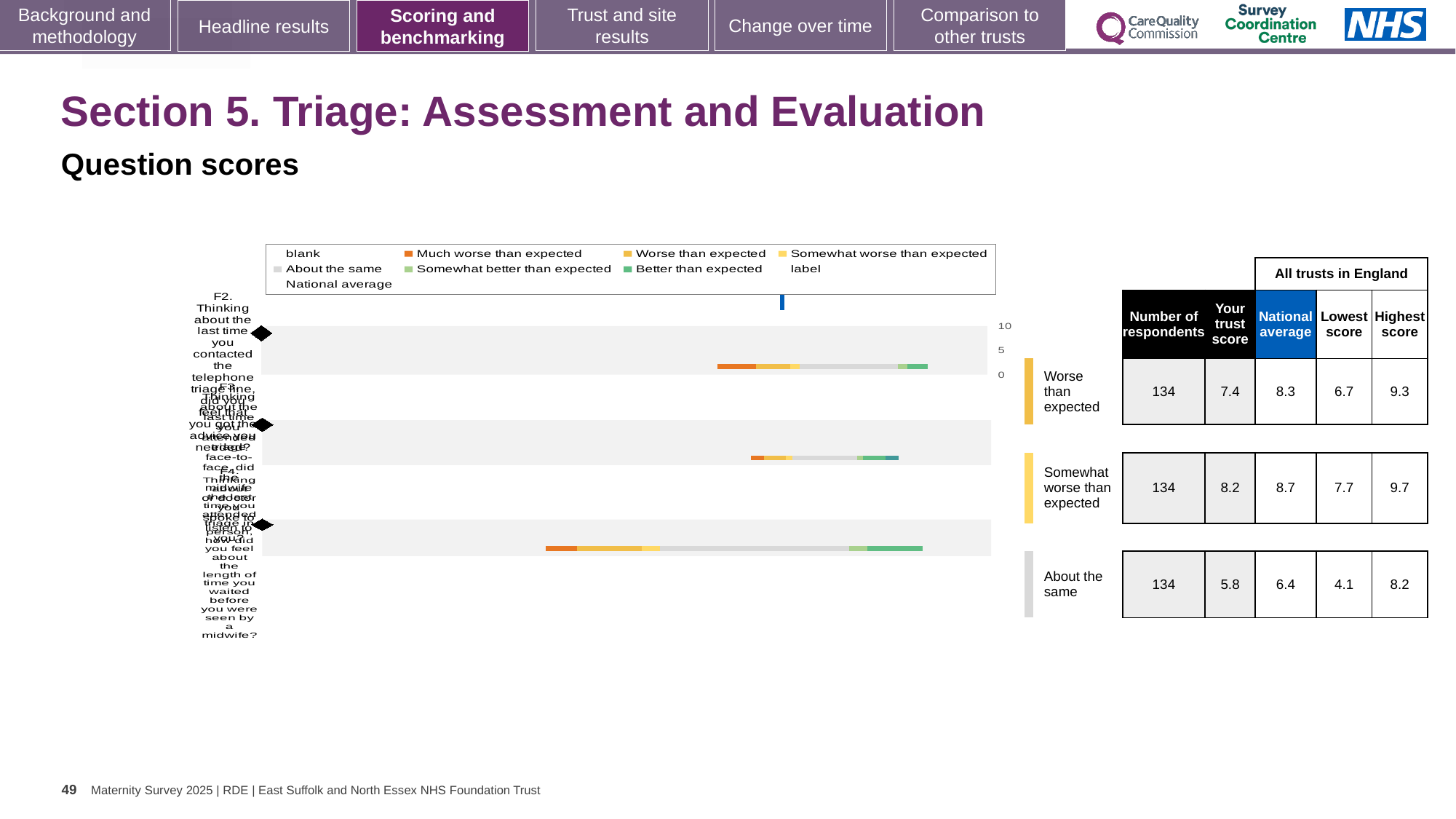
In the table, what is the lowest score for the row labelled 'About the same'? 4.1 What kind of chart is shown on the slide? bar chart In the table, what is 'Your trust score' for the row labelled 'Worse than expected'? 7.4 How many question rows are shown in the table? 3 In the table, is 'Your trust score' or the national average larger for the row labelled 'About the same'? National average In the table, what is the national average for the row labelled 'Somewhat worse than expected'? 8.7 In the table, what is the difference between the national average and 'Your trust score' for the row labelled 'Worse than expected'? 0.9 In the table, which row has the highest national average? Somewhat worse than expected In the table, what is the number of respondents for the row labelled 'Worse than expected'? 134 In the table, which row has the lowest 'Your trust score'? About the same In the table, what is the highest score for the row labelled 'Somewhat worse than expected'? 9.7 What is the highest tick value shown on the chart's axis? 10